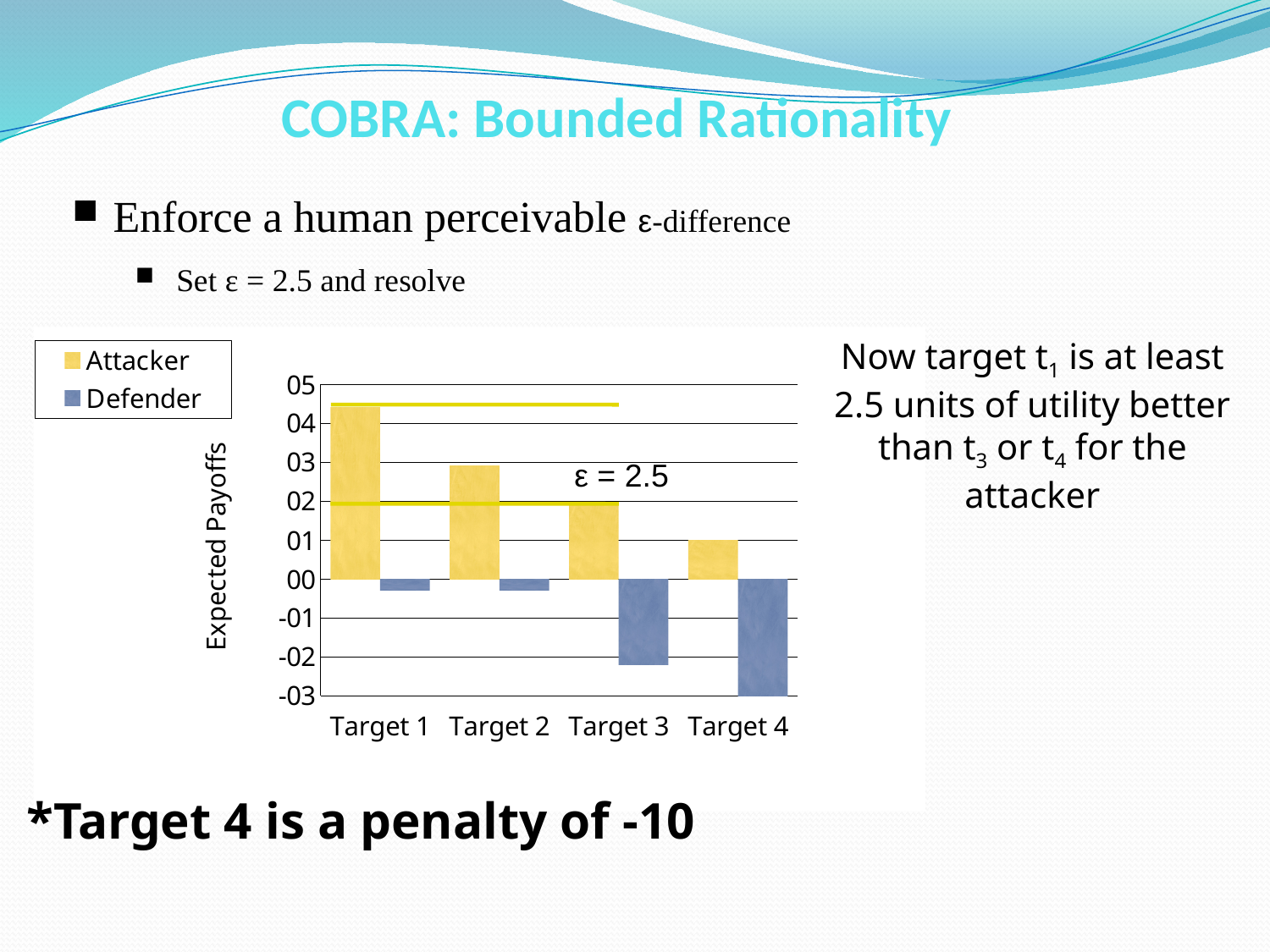
What kind of chart is shown on the slide? bar chart Which target has the lowest Defender expected payoff? Target 4 Which is larger, the Attacker expected payoff for Target 2 or for Target 4? Target 2 What is the label on the vertical axis of the chart? Expected Payoffs Is the Attacker expected payoff for Target 1 greater or less than 04? greater How many series does the chart legend list? 2 Is the Defender expected payoff for Target 3 greater or less than -01? less Which target has the lowest Attacker expected payoff? Target 4 How many targets (categories) are shown on the x axis of the chart? 4 Which colour represents the Defender series in the chart? blue Which target has the highest Attacker expected payoff? Target 1 Do the Attacker expected payoffs rise or fall from Target 1 to Target 4? fall